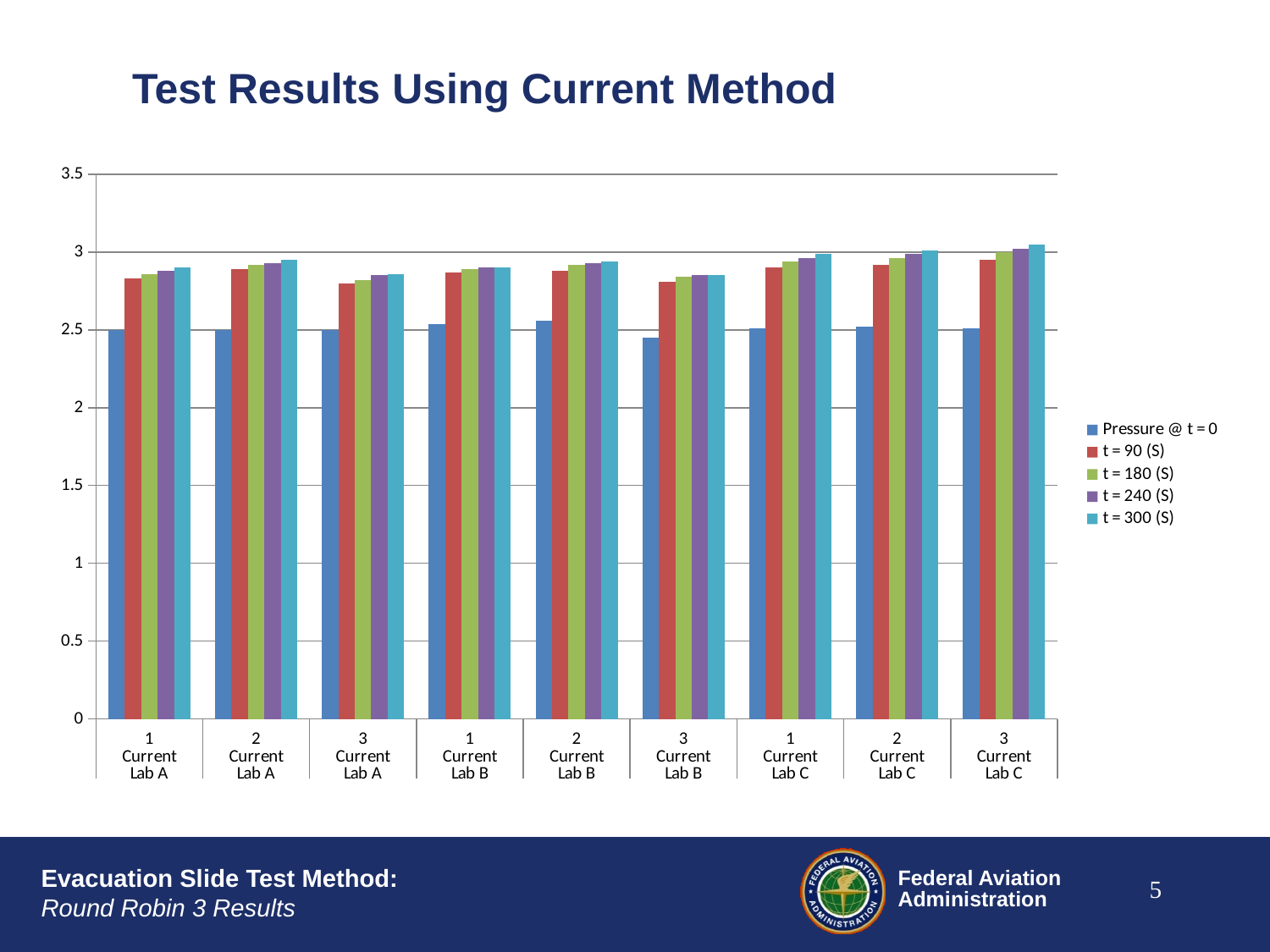
Which series has the lowest value for the category '3 Current Lab B'? Pressure @ t = 0 How many series does the legend list? 5 Is the value of 't = 300 (S)' for '3 Current Lab C' greater or less than 3? greater How many categories are shown along the x axis? 9 Which series has the highest value for the category '3 Current Lab C'? t = 300 (S) What kind of chart is shown on the slide? bar chart What is the title of the chart? Test Results Using Current Method For '2 Current Lab C', which is larger: the value for 'Pressure @ t = 0' or the value for 't = 90 (S)'? t = 90 (S) Within the category '1 Current Lab C', do the values rise or fall from 'Pressure @ t = 0' to 't = 300 (S)'? rise What is the first entry listed in the legend? Pressure @ t = 0 Is the value of 'Pressure @ t = 0' for '3 Current Lab B' greater or less than 2.5? less Is the value of 't = 90 (S)' for '1 Current Lab A' greater or less than 3? less